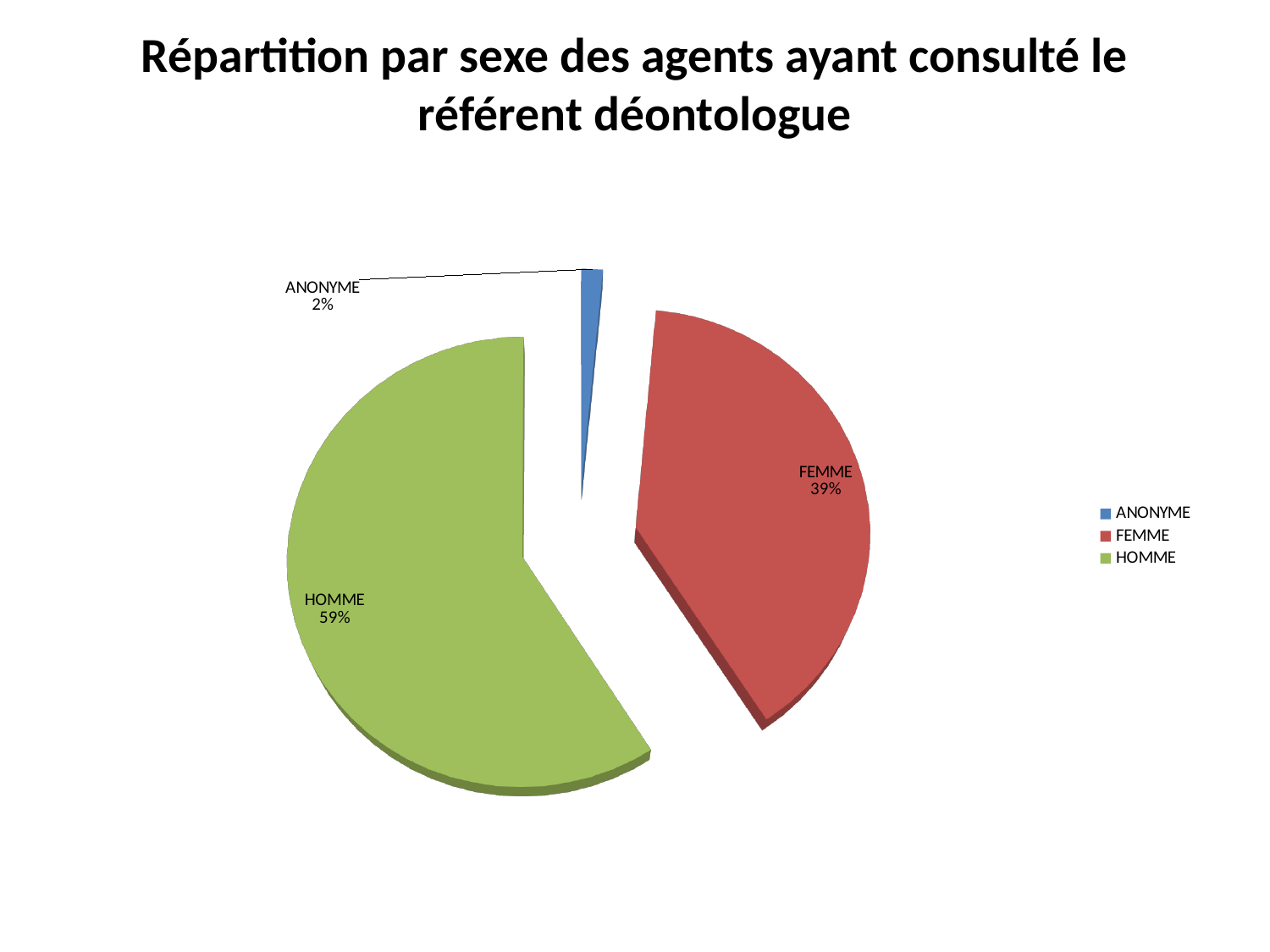
Which category has the largest slice of the pie? HOMME What share of the pie does ANONYME represent? 2% Which category has the smallest slice of the pie? ANONYME What share of the pie does HOMME represent? 59% What is the difference in percentage points between FEMME and ANONYME? 37 Which is larger, the share for FEMME or the share for ANONYME? FEMME What kind of chart is shown on the slide? Pie chart What is the title of the chart? Répartition par sexe des agents ayant consulté le référent déontologue What colour is the HOMME slice? Green What share of the pie does FEMME represent? 39% How many categories are shown in the pie chart? 3 What is the difference in percentage points between HOMME and FEMME? 20